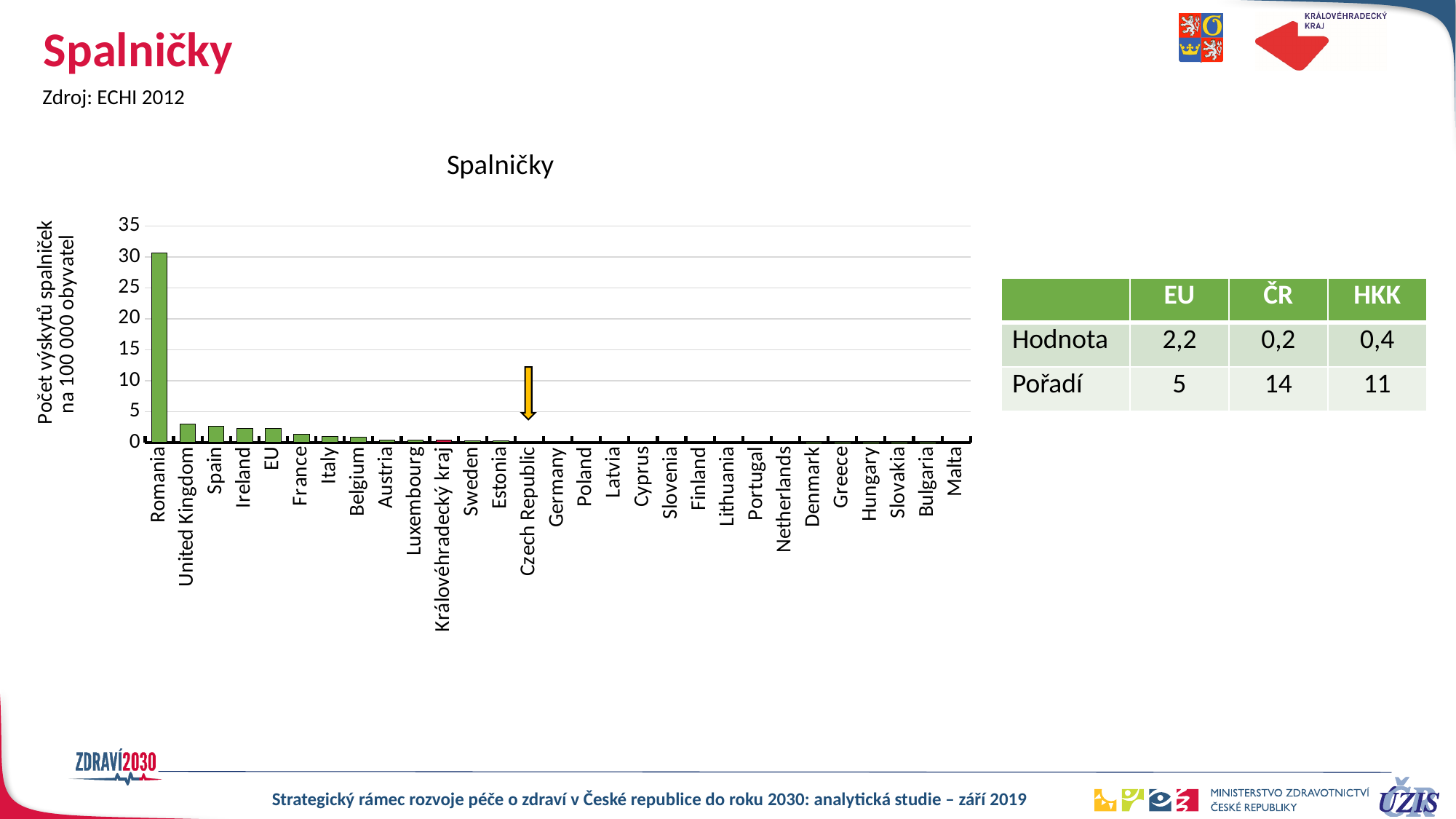
What type of chart is shown on the slide? bar chart What is the title of the chart? Spalničky Which has a larger value, Romania or United Kingdom? Romania Is the value for Romania greater or less than 25? greater How many categories are shown on the x axis of the chart? 29 Is the value for Ireland greater or less than 5? less Is the value for United Kingdom greater or less than 5? less Which country has the highest value in the Spalničky chart? Romania Which category on the x axis does the yellow arrow point to? Czech Republic According to the table next to the chart, what is the value (Hodnota) for EU? 2,2 Do the values generally rise or fall from left to right along the x axis? fall Which has a larger value, Spain or France? Spain